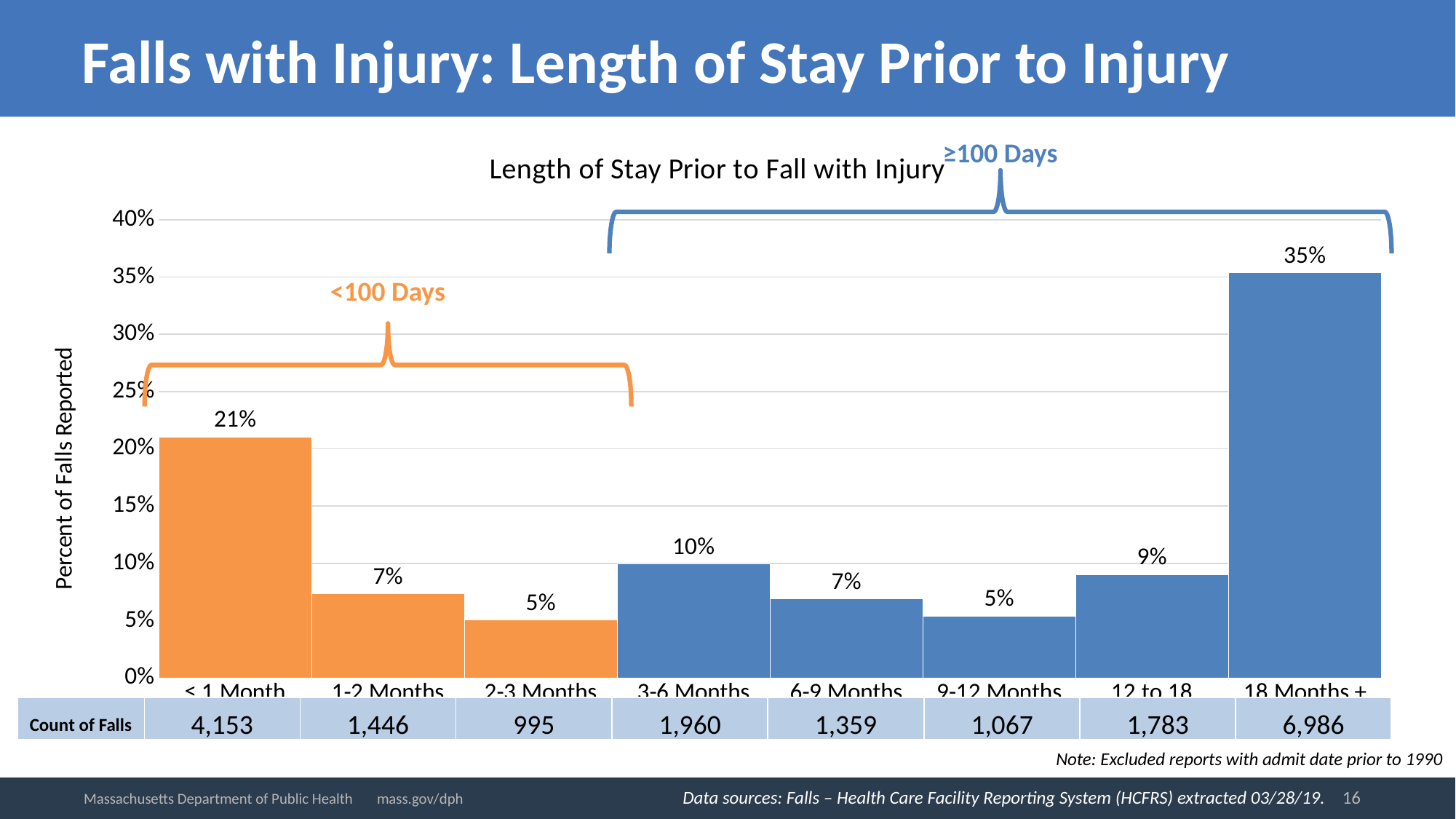
What percent of falls reported occurred for residents with a length of stay of less than 1 month? 21% What is the count of falls for the 18 Months + category? 6,986 What is the difference in percent of falls reported between the 18 Months + and < 1 Month categories? 14% What is the count of falls for the 2-3 Months category? 995 What is the title of the chart? Length of Stay Prior to Fall with Injury Which has a higher percent of falls reported, 3-6 Months or 12 to 18? 3-6 Months How many length-of-stay categories are shown on the chart? 8 Is the value for < 1 Month greater or less than 20%? greater Which categories are grouped under the orange '<100 Days' bracket? < 1 Month, 1-2 Months, 2-3 Months What kind of chart is shown on the slide? Bar chart Which length-of-stay category has the highest percent of falls reported? 18 Months + What percent of falls reported is shown for the 3-6 Months category? 10%